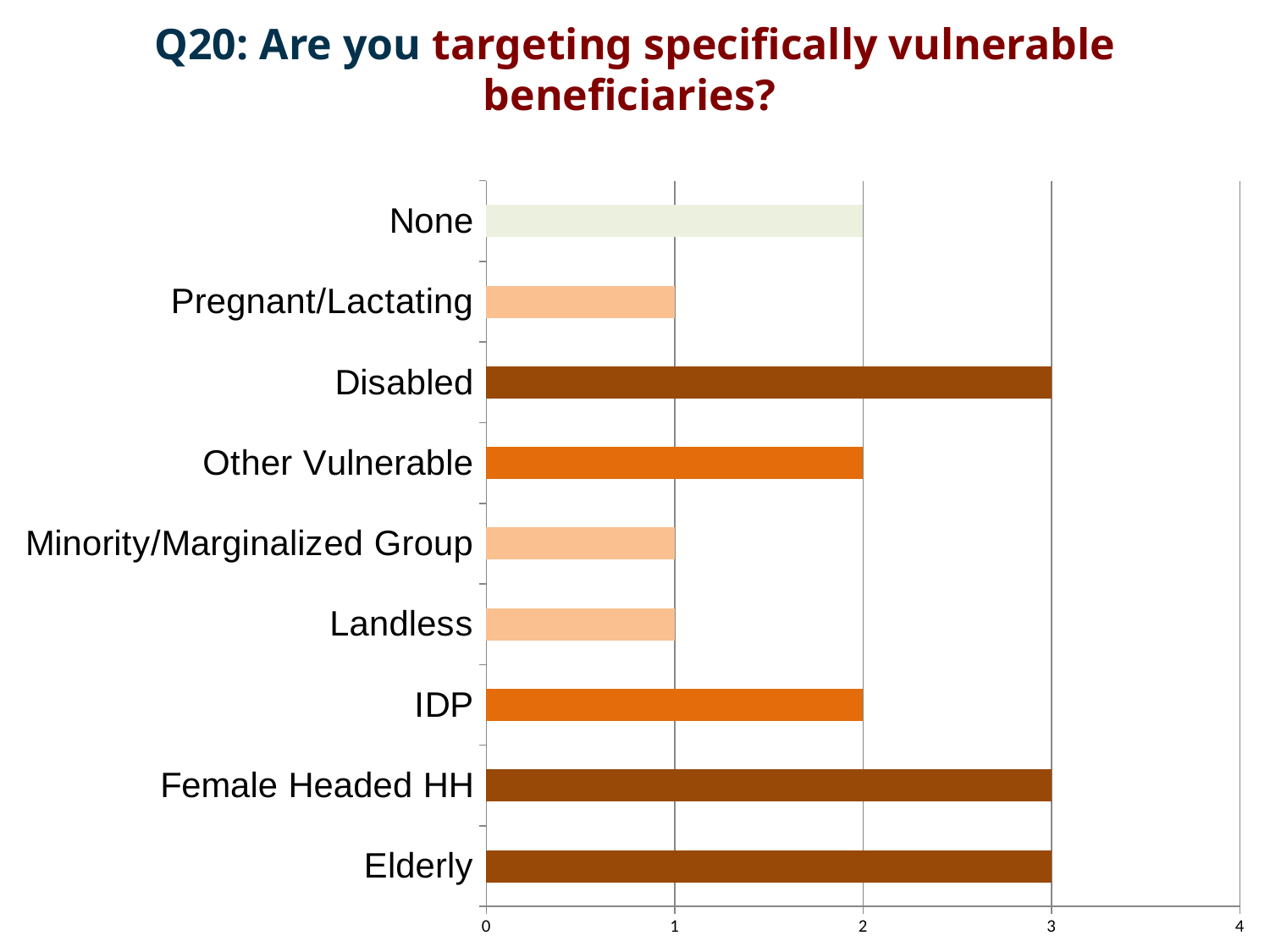
What is the difference between the value for Elderly and the value for Minority/Marginalized Group? 2 How many categories are shown in the chart? 9 What is the title of the chart? Q20: Are you targeting specifically vulnerable beneficiaries? What is the value for Disabled? 3 How many categories have a value of 3? 3 What is the value for IDP? 2 What type of chart is shown on the slide? bar chart What is the value for None? 2 Is the value for Disabled greater or less than 2? greater What is the value for Landless? 1 What is the value for Pregnant/Lactating? 1 Which is larger, the value for Female Headed HH or the value for Other Vulnerable? Female Headed HH